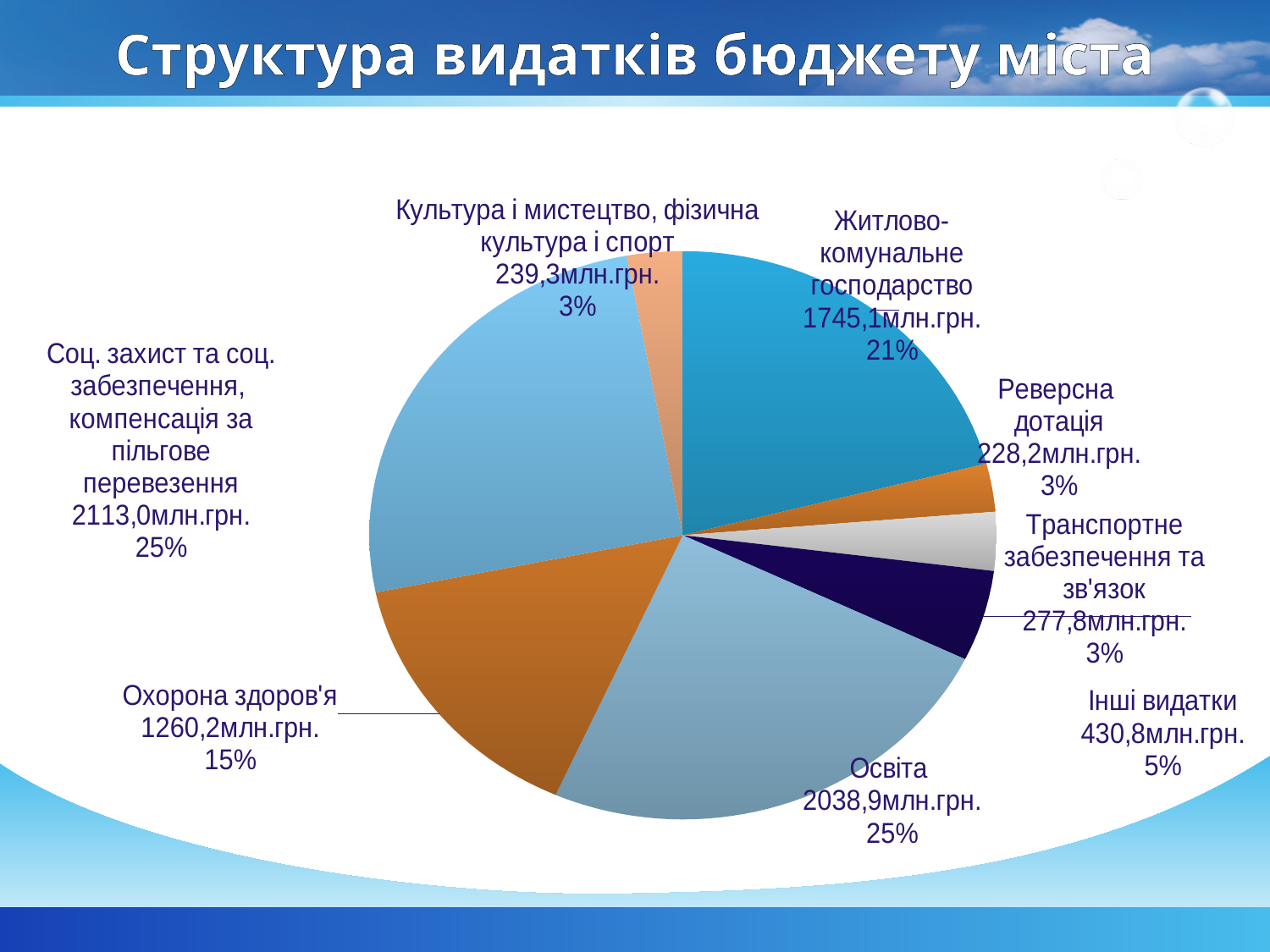
What kind of chart is shown on the slide? Pie chart What is the difference between the values for Освіта and Охорона здоров'я? 778,7млн.грн. What share of the pie does Інші видатки represent? 5% What share of the pie does Житлово-комунальне господарство represent? 21% Which is larger: Транспортне забезпечення та зв'язок or Реверсна дотація? Транспортне забезпечення та зв'язок What is the title of the chart? Структура видатків бюджету міста What is the value for Охорона здоров'я? 1260,2млн.грн. Which category has the smallest value? Реверсна дотація What is the value for Житлово-комунальне господарство? 1745,1млн.грн. Which category has the largest value in млн.грн.? Соц. захист та соц. забезпечення, компенсація за пільгове перевезення What is the value for Освіта? 2038,9млн.грн. How many categories (slices) does the pie chart show? 8